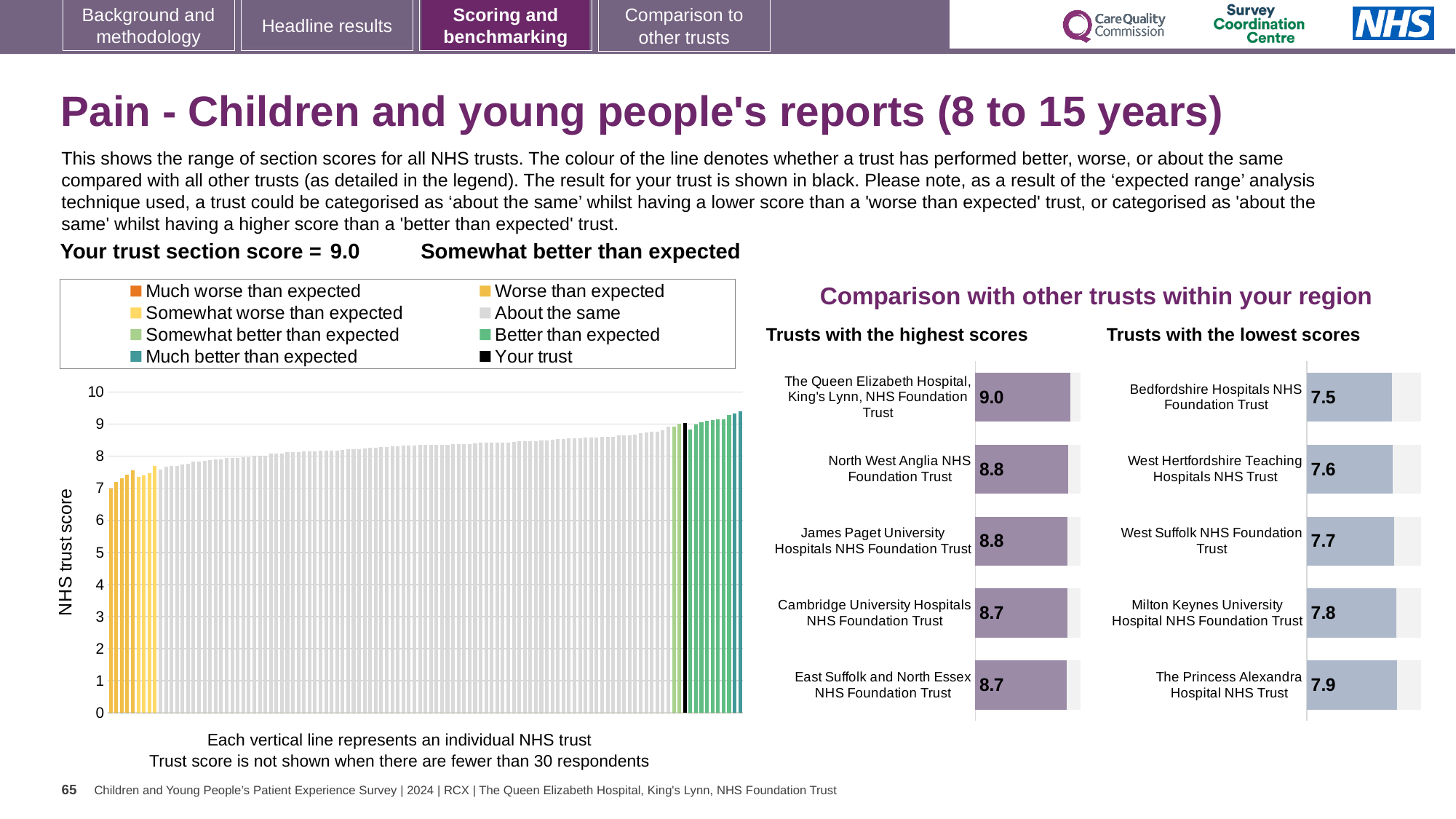
In the 'Trusts with the highest scores' chart, what is the score for Cambridge University Hospitals NHS Foundation Trust? 8.7 In the NHS trust score chart on the left, do the trust scores rise or fall from left to right? rise In the 'Trusts with the lowest scores' chart, which trust has the highest score? The Princess Alexandra Hospital NHS Trust In the 'Trusts with the lowest scores' chart, which trust has the lowest score? Bedfordshire Hospitals NHS Foundation Trust In the 'Trusts with the lowest scores' chart, which has the larger score: West Suffolk NHS Foundation Trust or West Hertfordshire Teaching Hospitals NHS Trust? West Suffolk NHS Foundation Trust What kind of chart is the NHS trust score chart on the left? bar chart In the 'Trusts with the highest scores' chart, what is the difference between the scores of The Queen Elizabeth Hospital, King's Lynn, NHS Foundation Trust and East Suffolk and North Essex NHS Foundation Trust? 0.3 In the 'Trusts with the lowest scores' chart, what is the score for Bedfordshire Hospitals NHS Foundation Trust? 7.5 In the NHS trust score chart on the left, what is the section score for your trust (the black line)? 9.0 How many trusts are listed in the 'Trusts with the highest scores' chart? 5 How many entries does the legend of the NHS trust score chart on the left list? 8 In the 'Trusts with the highest scores' chart, what is the score for The Queen Elizabeth Hospital, King's Lynn, NHS Foundation Trust? 9.0